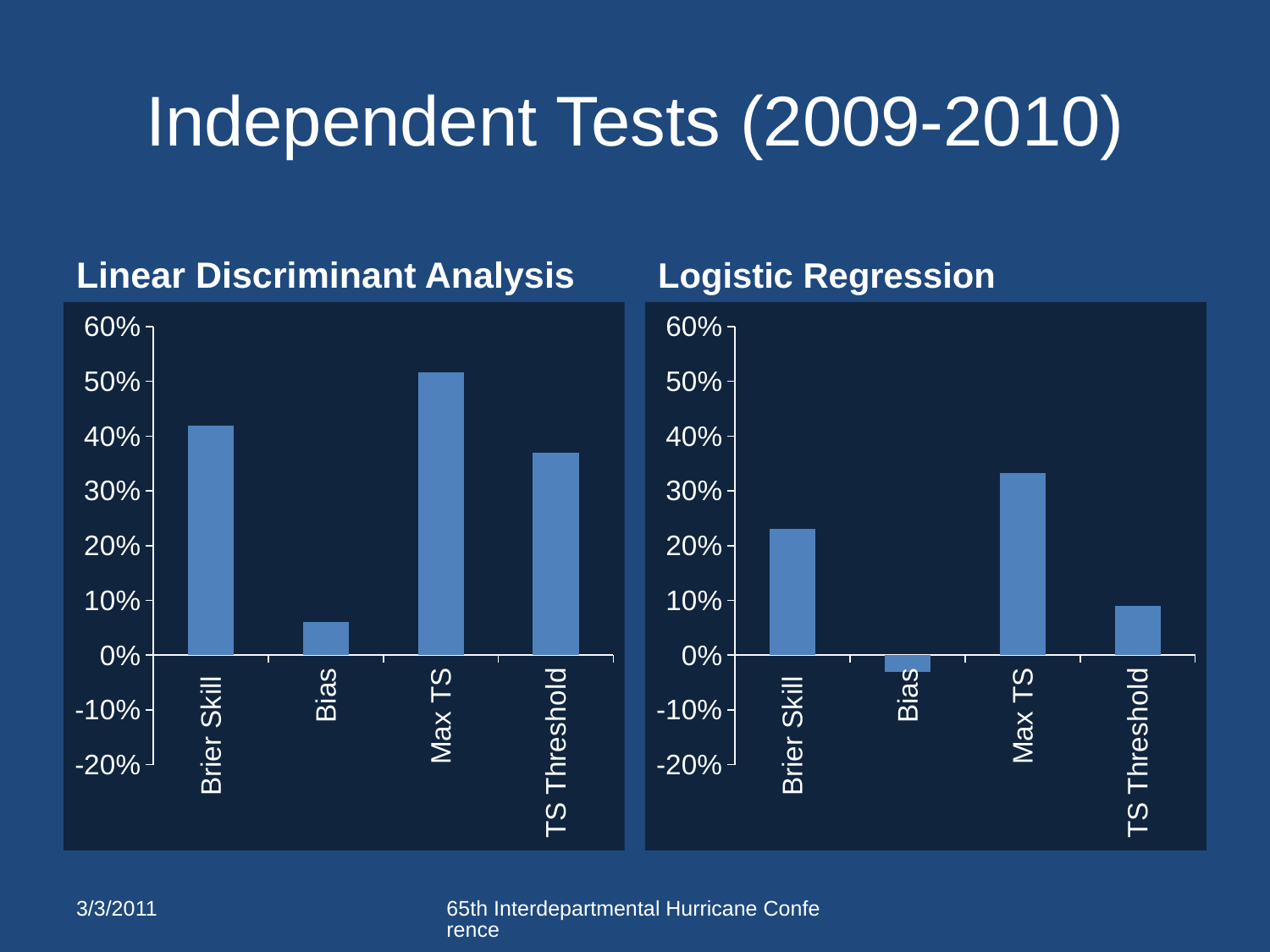
Which chart has the larger value for Max TS, Linear Discriminant Analysis or Logistic Regression? Linear Discriminant Analysis In the Logistic Regression chart, which category has the highest value? Max TS In the Linear Discriminant Analysis chart, which is larger, Brier Skill or TS Threshold? Brier Skill In the Logistic Regression chart, which category has the lowest value? Bias What kind of chart is the Linear Discriminant Analysis chart? bar chart In the Logistic Regression chart, is the value for Bias greater or less than 0%? less What is the title of the chart on the right side of the slide? Logistic Regression How many categories are shown on the Logistic Regression chart? 4 In the Linear Discriminant Analysis chart, is the value for Brier Skill greater or less than 40%? greater In the Linear Discriminant Analysis chart, which category has the highest value? Max TS In the Linear Discriminant Analysis chart, which category has the lowest value? Bias